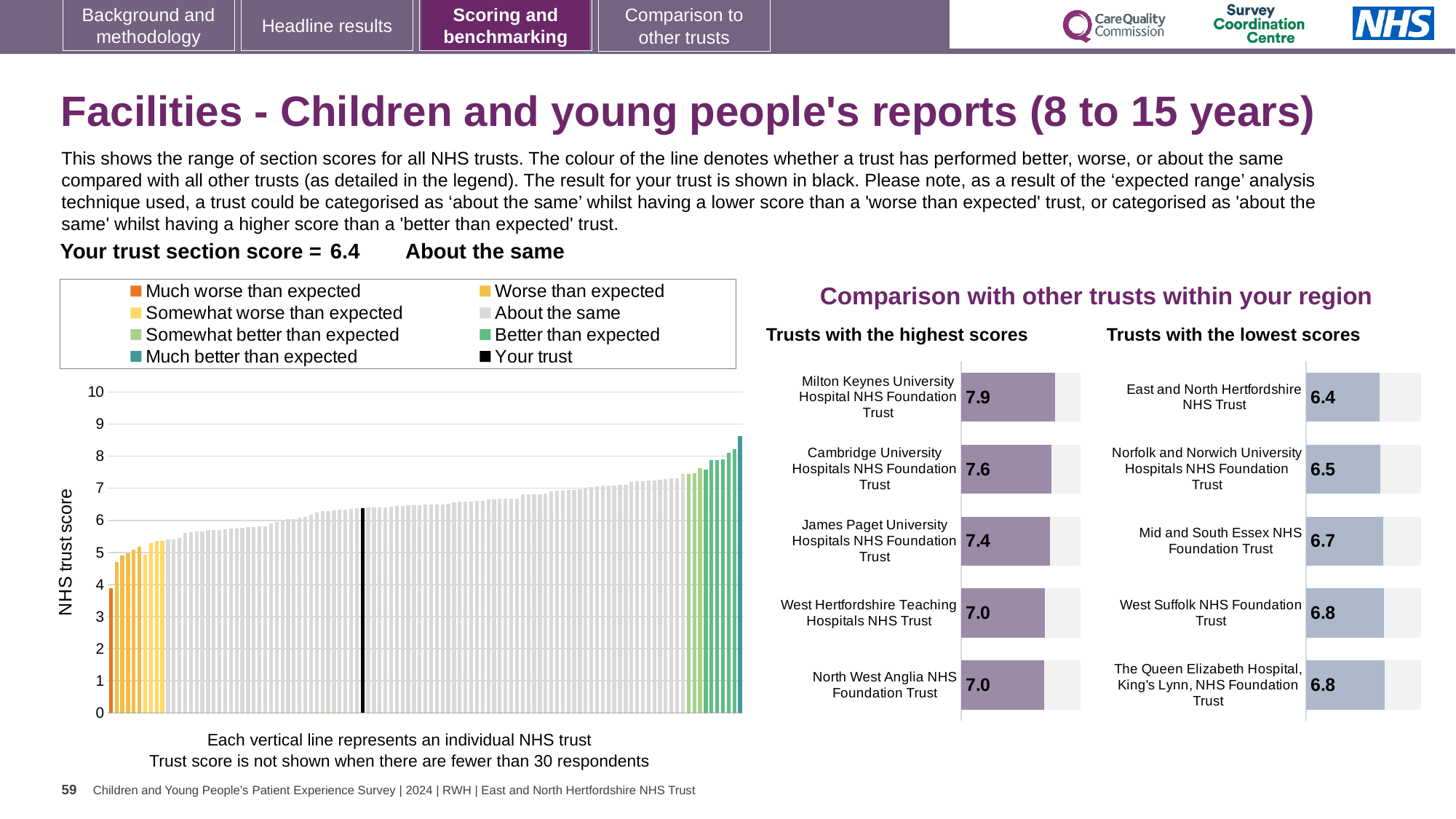
In the 'Trusts with the lowest scores' chart, what is the difference between the scores of The Queen Elizabeth Hospital, King's Lynn, NHS Foundation Trust and East and North Hertfordshire NHS Trust? 0.4 How many trusts are shown in the 'Trusts with the highest scores' chart? 5 In the 'Trusts with the lowest scores' chart, which trust has the lowest score? East and North Hertfordshire NHS Trust In the 'Trusts with the lowest scores' chart, which has the larger score: Norfolk and Norwich University Hospitals NHS Foundation Trust or West Suffolk NHS Foundation Trust? West Suffolk NHS Foundation Trust In the 'NHS trust score' chart on the left, do the bar values rise or fall from left to right? Rise In the 'Trusts with the highest scores' chart, what is the score for Milton Keynes University Hospital NHS Foundation Trust? 7.9 What kind of chart is the 'NHS trust score' chart on the left of the slide? Bar chart In the 'Trusts with the highest scores' chart, what is the difference between the scores of Milton Keynes University Hospital NHS Foundation Trust and Cambridge University Hospitals NHS Foundation Trust? 0.3 How many entries does the legend of the 'NHS trust score' chart on the left list? 8 In the 'Trusts with the lowest scores' chart, what is the score for Mid and South Essex NHS Foundation Trust? 6.7 In the 'Trusts with the highest scores' chart, which trust has the highest score? Milton Keynes University Hospital NHS Foundation Trust In the 'NHS trust score' chart on the left, is the value of the tallest bar greater or less than 8? greater